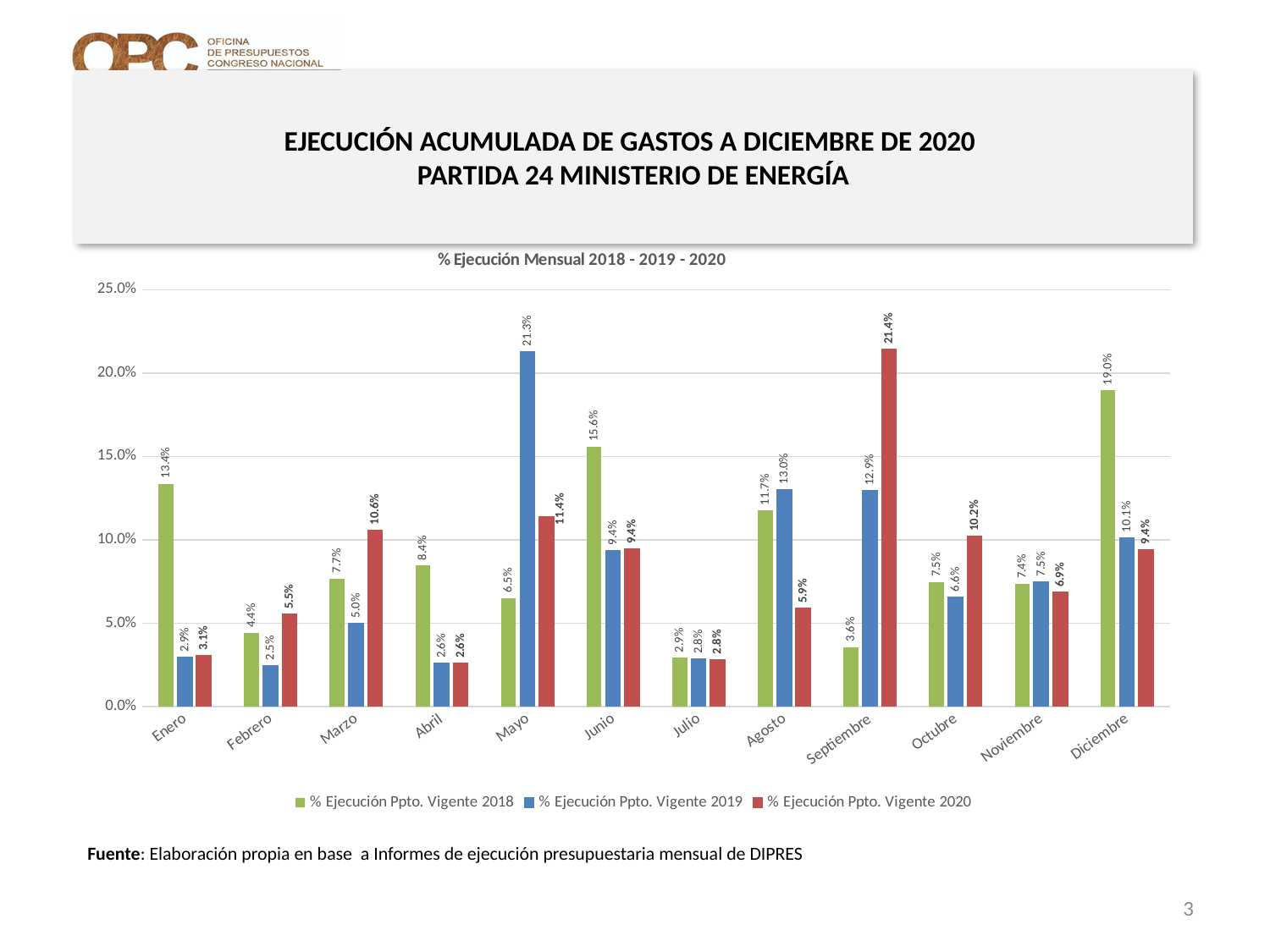
Is the value for Diciembre in the 2018 series greater or less than 15.0%? greater What is the value for Enero in the % Ejecución Ppto. Vigente 2018 series? 13.4% Which month has the lowest value in the % Ejecución Ppto. Vigente 2019 series? Febrero What is the value for Septiembre in the % Ejecución Ppto. Vigente 2020 series? 21.4% What kind of chart is shown on the slide? Bar chart How many months are shown on the x axis? 12 Which is larger for Agosto: the 2018 value or the 2019 value? 2019 How many series does the legend list? 3 What is the title of the chart? % Ejecución Mensual 2018 - 2019 - 2020 What is the difference between the 2020 and 2018 values for Marzo? 2.9% Which month has the highest value in the % Ejecución Ppto. Vigente 2018 series? Diciembre What is the value for Mayo in the % Ejecución Ppto. Vigente 2019 series? 21.3%